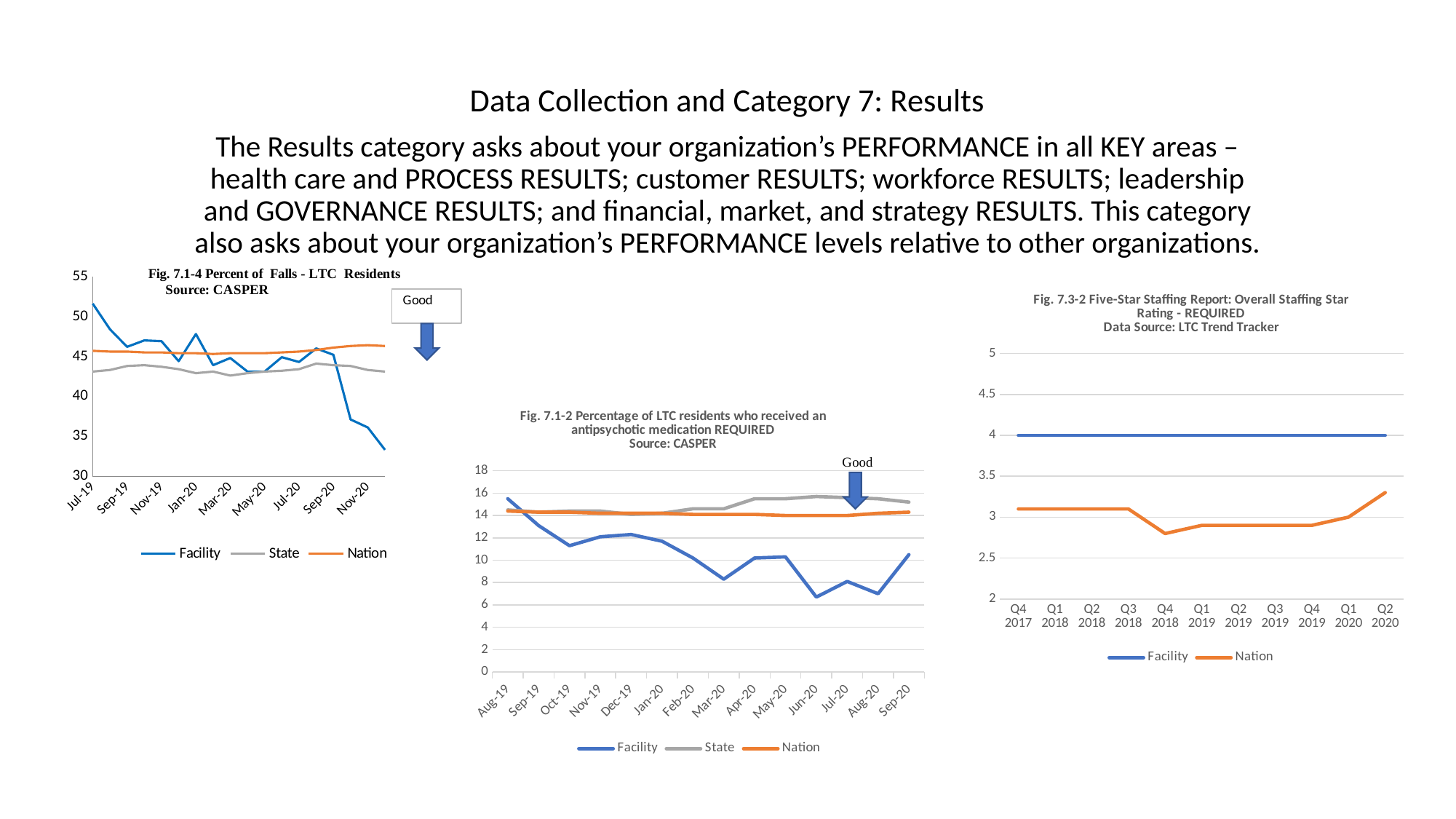
In Fig. 7.3-2 Five-Star Staffing Report, what is the Facility overall staffing star rating across all quarters? 4 In Fig. 7.3-2 Five-Star Staffing Report, in which quarter is the Nation value lowest? Q4 2018 In Fig. 7.1-4 Percent of Falls - LTC Residents, which series is higher at Nov-20, Facility or Nation? Nation What kind of chart is Fig. 7.1-4 Percent of Falls - LTC Residents? line chart How many series does the legend list in Fig. 7.1-4 Percent of Falls - LTC Residents? 3 How many months are plotted on the x axis of Fig. 7.1-2 Percentage of LTC residents who received an antipsychotic medication? 14 How many series does the legend list in Fig. 7.3-2 Five-Star Staffing Report? 2 In Fig. 7.1-4 Percent of Falls - LTC Residents, is the Facility value at Jul-19 greater or less than 50? greater In Fig. 7.1-2 Percentage of LTC residents who received an antipsychotic medication, is the Facility value at Jun-20 greater or less than 8? less In Fig. 7.1-2 Percentage of LTC residents who received an antipsychotic medication, which series is higher at Mar-20, Facility or State? State In Fig. 7.1-4 Percent of Falls - LTC Residents, does the Facility line rise or fall overall from Jul-19 to the end of the series? fall In Fig. 7.1-2 Percentage of LTC residents who received an antipsychotic medication, at which month is the Facility value lowest? Jun-20